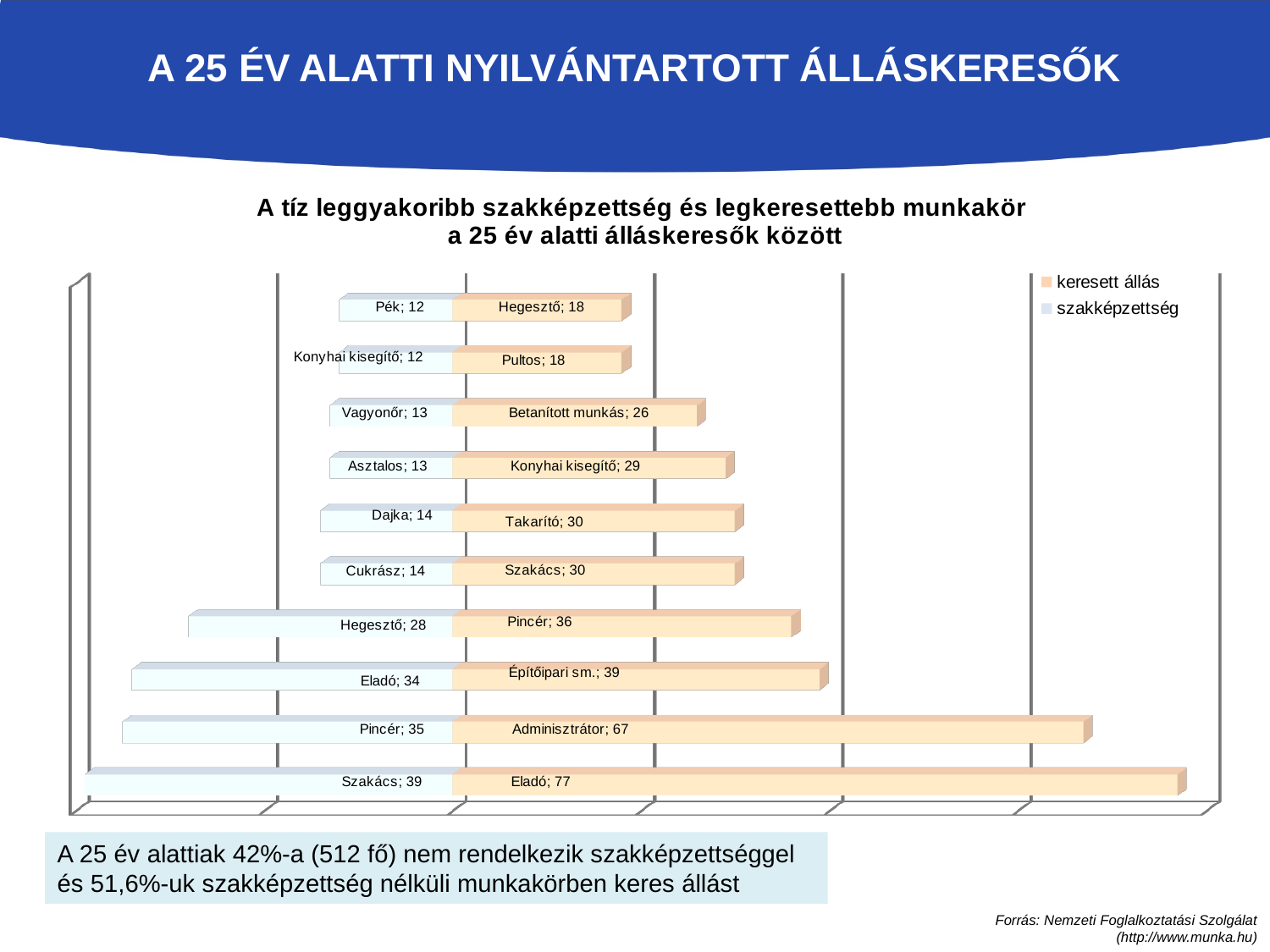
Which is larger: Pincér in the keresett állás series or Hegesztő in the szakképzettség series? Pincér in keresett állás What is the value for Betanított munkás in the keresett állás series? 26 Which category has the highest value in the szakképzettség series? Szakács What type of chart is shown on the slide? bar chart What is the difference between Eladó (77) and Adminisztrátor (67) in the keresett állás series? 10 What is the value for Szakács in the szakképzettség series? 39 Which category has the highest value in the keresett állás series? Eladó How many categories are plotted in the keresett állás series? 10 How many series does the legend list? 2 What are the two series named in the legend? keresett állás and szakképzettség What is the difference between Szakács (39) and Pincér (35) in the szakképzettség series? 4 What is the value for Adminisztrátor in the keresett állás series? 67